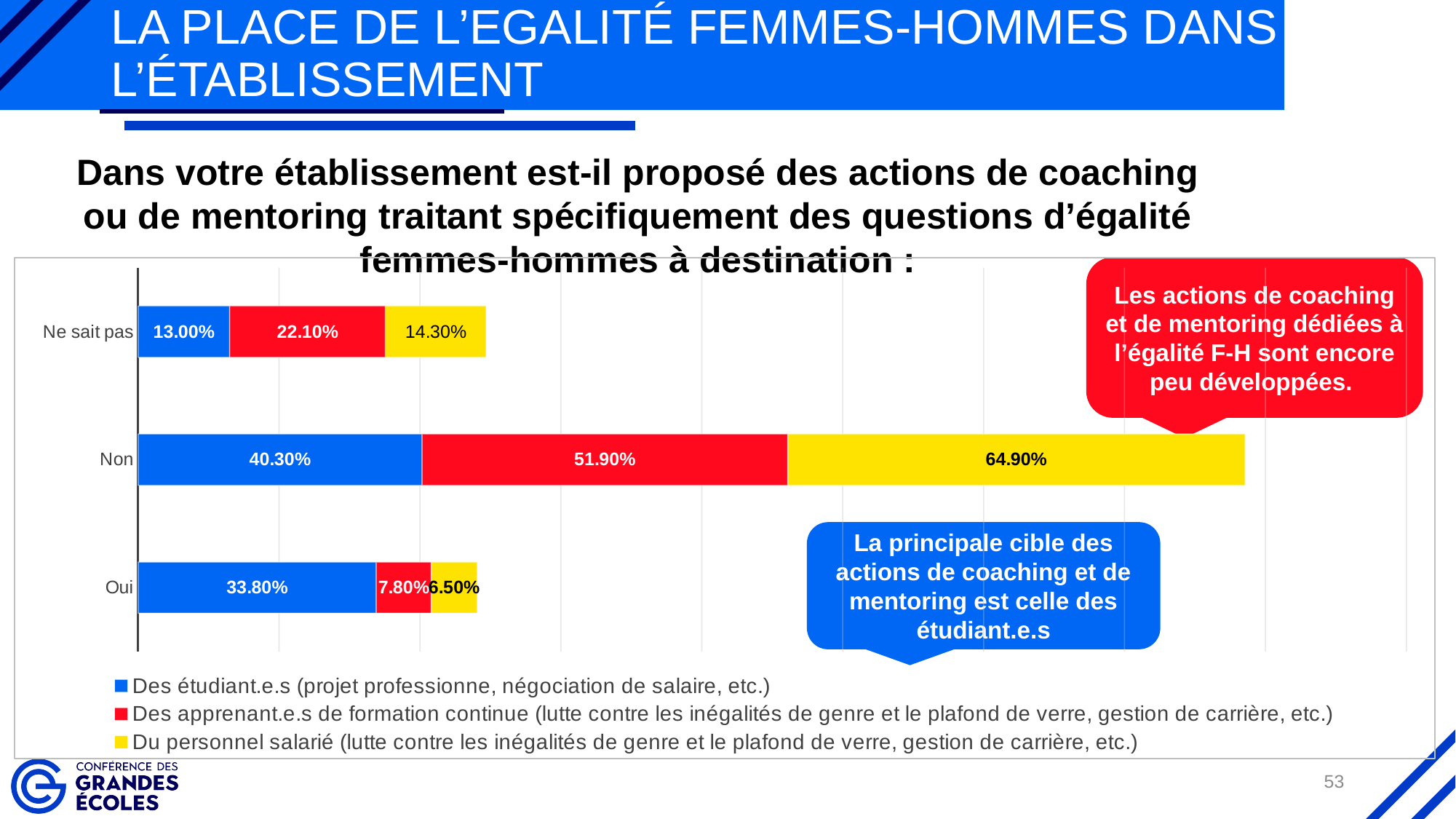
What is the value for "Des étudiant.e.s" in the "Oui" category? 33.80% Which category has the highest value for "Des étudiant.e.s"? Non How many series does the legend list? 3 Which series has the lowest value in the "Oui" category? Du personnel salarié What is the value for "Du personnel salarié" in the "Oui" category? 6.50% What is the difference between the "Des étudiant.e.s" and "Du personnel salarié" values in the "Oui" category? 27.30 percentage points What is the total of the stacked bar for the "Oui" category? 48.10% What is the value for "Du personnel salarié" in the "Non" category? 64.90% What is the value for "Des apprenant.e.s de formation continue" in the "Ne sait pas" category? 22.10% How many categories are shown on the vertical axis? 3 What kind of chart is shown on the slide? Stacked bar chart In the "Non" category, which is larger: the value for "Des apprenant.e.s de formation continue" or for "Du personnel salarié"? Du personnel salarié